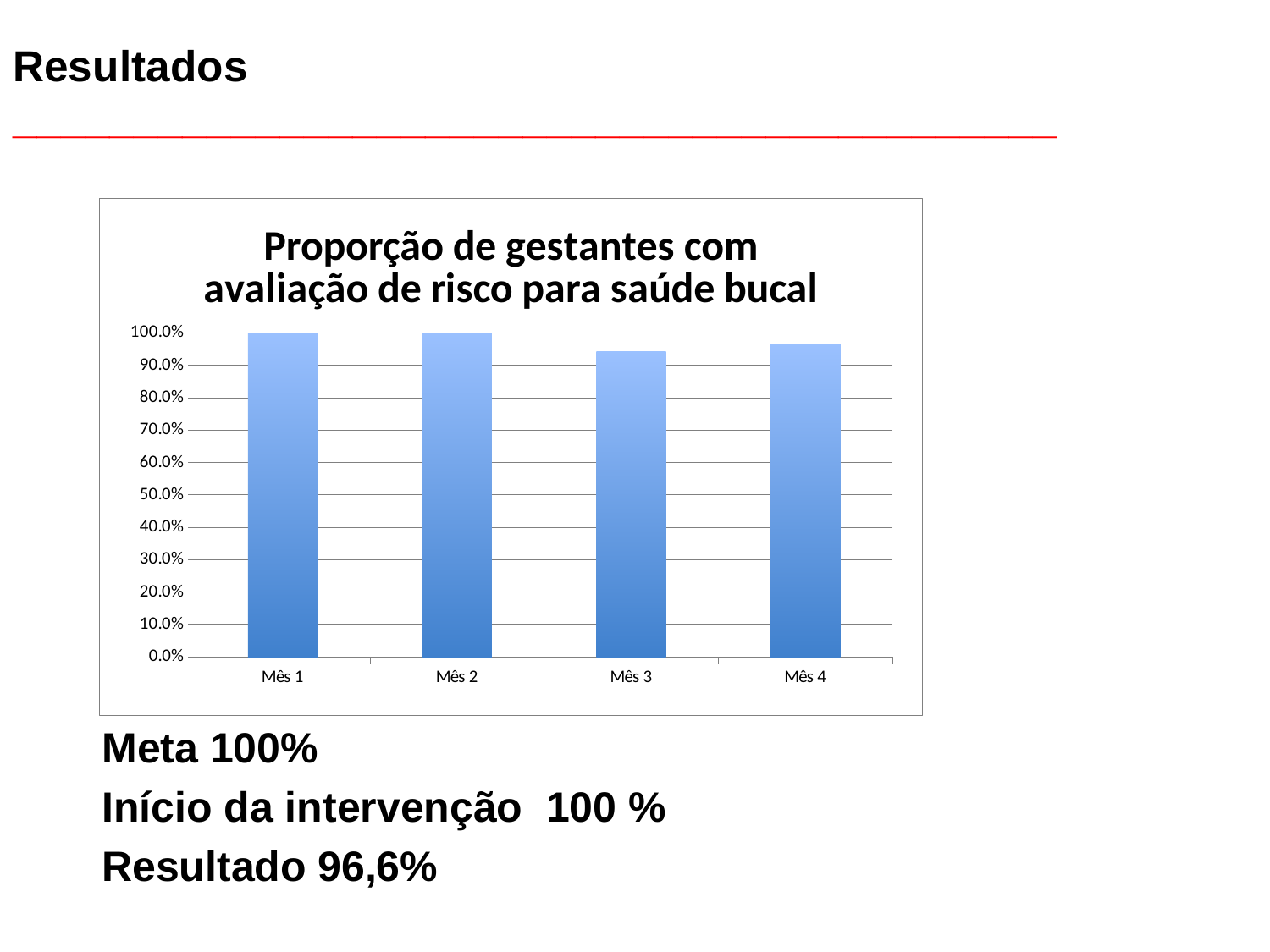
Is the value for Mês 3 greater or less than 100.0%? less What is the value for Mês 2? 100.0% What is the value for Mês 1? 100.0% What type of chart is shown on the slide? bar chart What is the title of the chart? Proporção de gestantes com avaliação de risco para saúde bucal Which is larger, the value for Mês 3 or the value for Mês 4? Mês 4 How many months (categories) are plotted in the chart? 4 Is the value for Mês 4 greater or less than 100.0%? less Does the value rise or fall from Mês 2 to Mês 3? fall Is the value for Mês 3 greater or less than 90.0%? greater What is the highest value shown on the vertical axis? 100.0% Which month has the lowest value? Mês 3